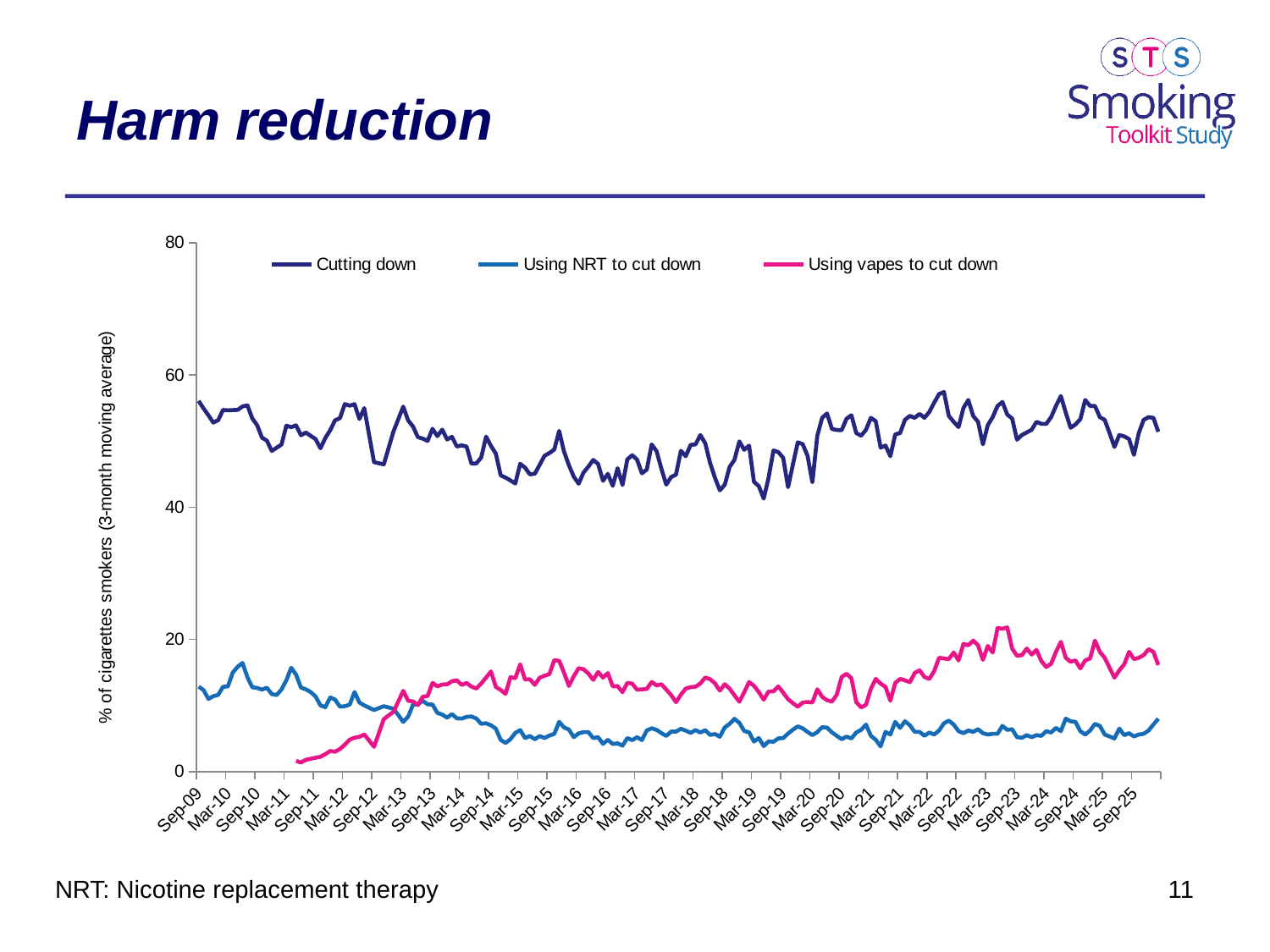
What colour is the line for Using vapes to cut down? pink Is the value for Using vapes to cut down at Sep-25 greater or less than 20? less Which series has the lowest value at Sep-25? Using NRT to cut down At Sep-25, which is larger: Using vapes to cut down or Using NRT to cut down? Using vapes to cut down Is the value for Using NRT to cut down at Sep-09 greater or less than 20? less Does the Using vapes to cut down series rise or fall overall from Sep-11 to Sep-25? rise Which series has the highest values across the whole period shown? Cutting down Is the value for Cutting down at Sep-09 greater or less than 40? greater How many series does the chart legend list? 3 What is the label on the vertical axis of the chart? % of cigarettes smokers (3-month moving average) What kind of chart is shown on the slide? line chart